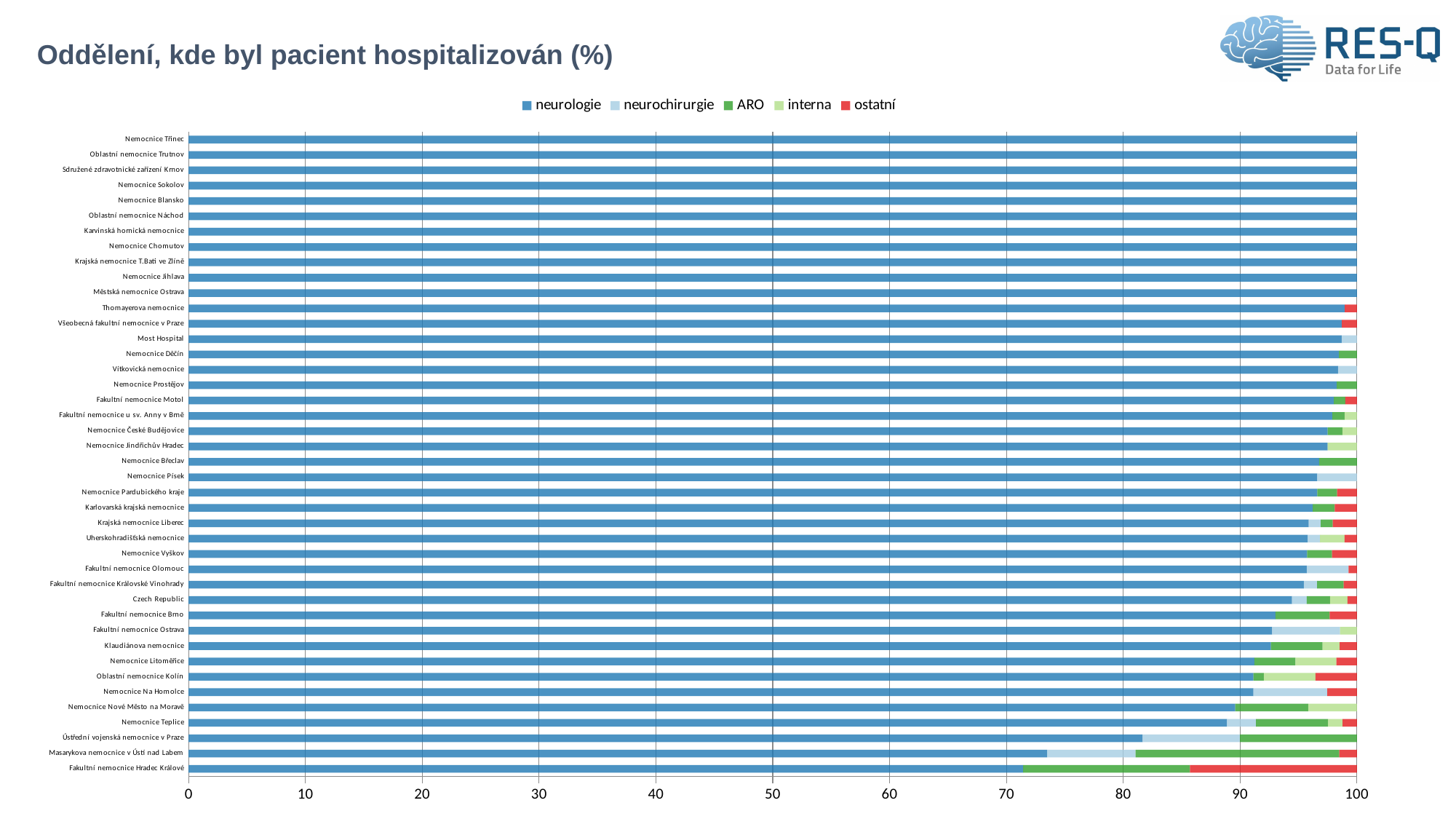
Which hospital has the largest ostatní share? Fakultní nemocnice Hradec Králové What colour represents the ostatní series in the legend? red What kind of chart is shown on the slide? stacked bar chart Is the neurologie value for Czech Republic greater or less than 90? greater Which hospital has the lowest neurologie share? Fakultní nemocnice Hradec Králové How many hospitals (categories) are plotted on the chart? 42 Which has the larger neurologie share, Nemocnice Třinec or Fakultní nemocnice Hradec Králové? Nemocnice Třinec How many series does the legend list? 5 Is the neurologie value for Nemocnice Teplice greater or less than 90? less Is the neurologie value for Fakultní nemocnice Hradec Králové greater or less than 80? less